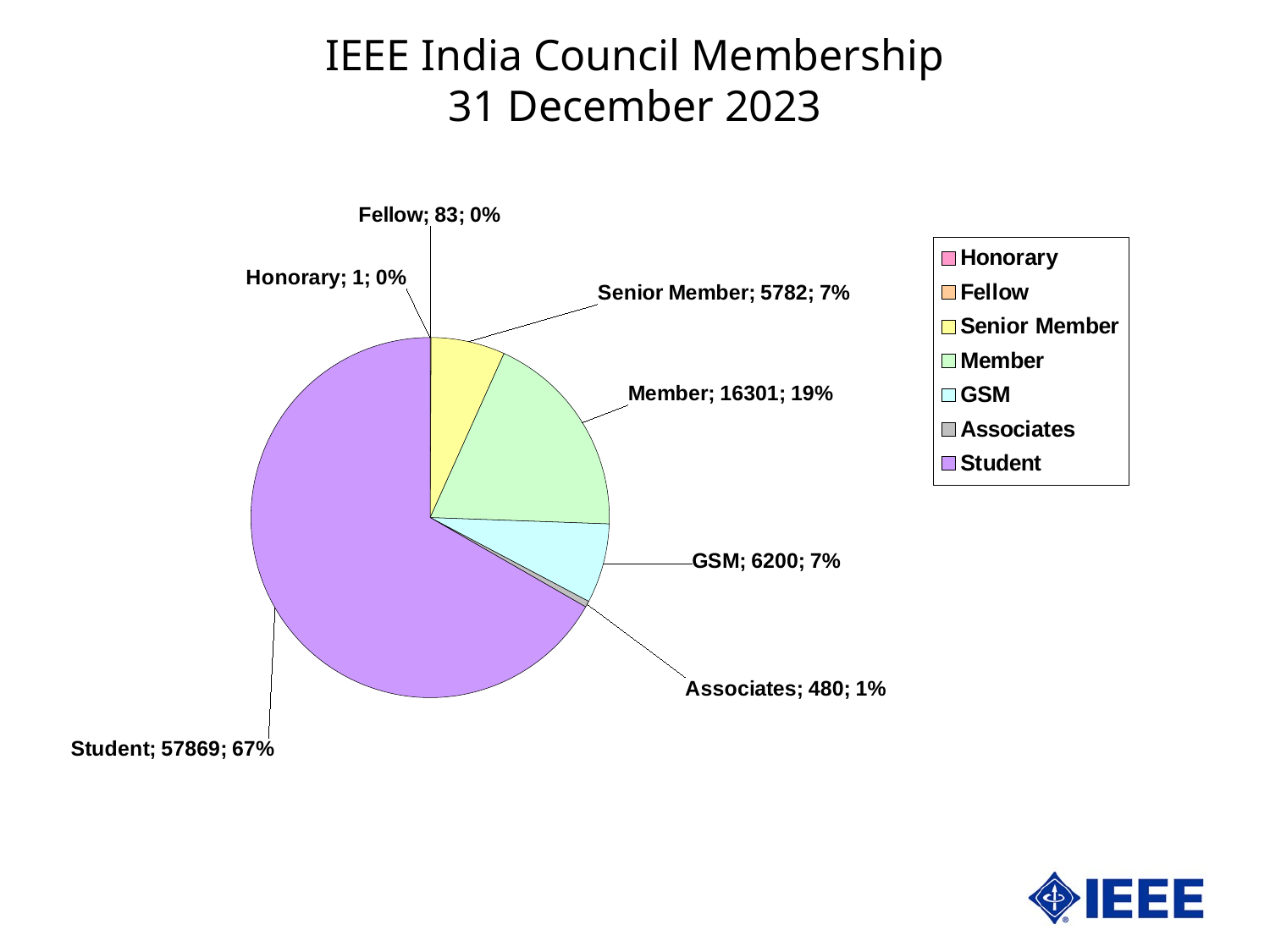
What share of the pie does Member represent? 19% What is the value for Senior Member? 5782 Which is larger, the value for Member or the value for GSM? Member What is the title of the chart? IEEE India Council Membership 31 December 2023 What type of chart is shown on the slide? pie chart What is the difference between the GSM value and the Senior Member value? 418 How many membership categories does the legend list? 7 Which category has the smallest slice? Honorary What is the value for Fellow? 83 What is the value for Member? 16301 Which category has the largest slice? Student What is the value for Student? 57869